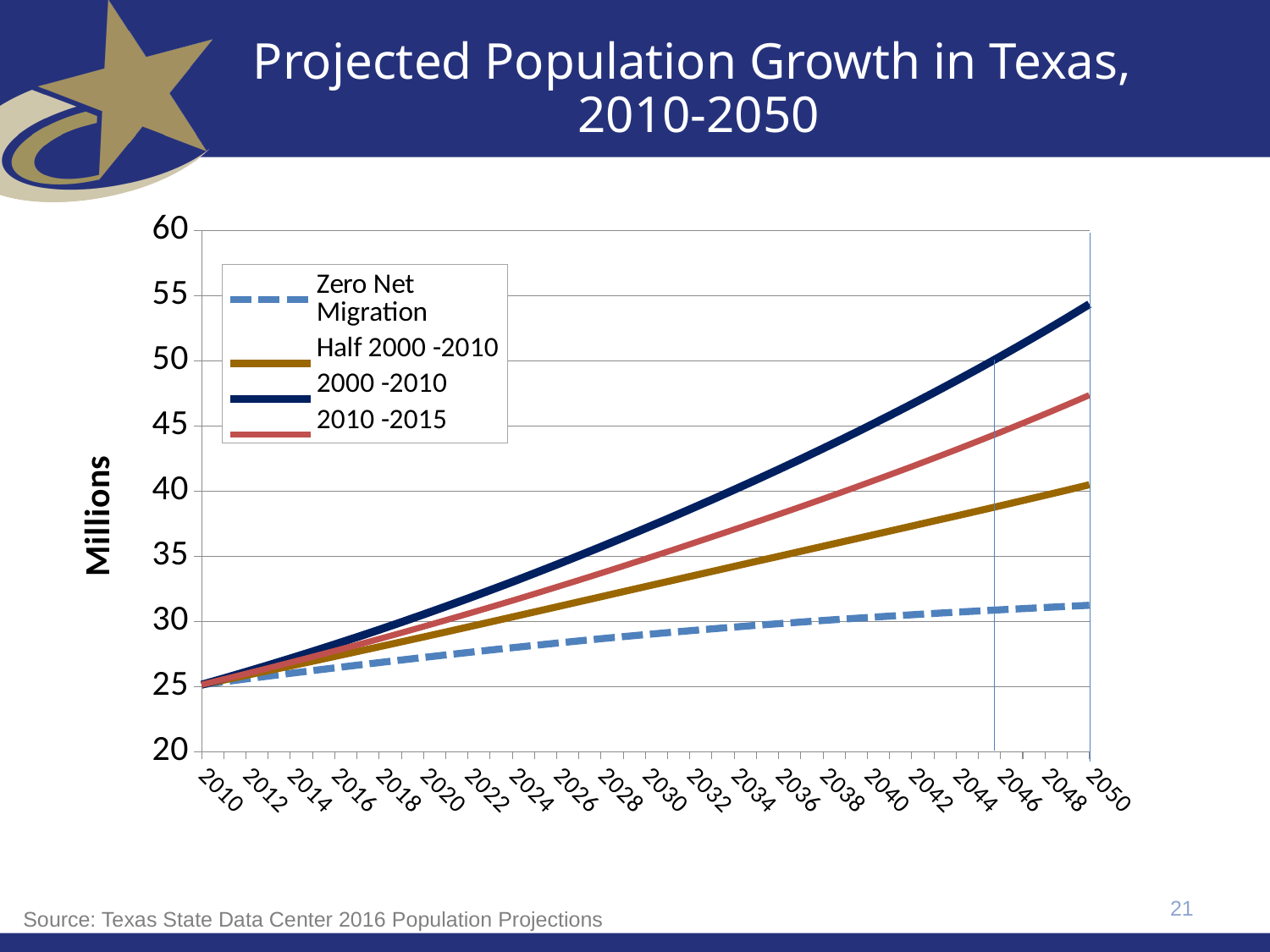
Is the value for the Half 2000 -2010 series in 2050 greater or less than 35? greater Is the value for the 2000 -2010 series in 2050 greater or less than 50? greater In 2050, which is larger: the 2010 -2015 series or the Half 2000 -2010 series? 2010 -2015 What is the label on the vertical axis of the chart? Millions Is the value for the 2010 -2015 series in 2050 greater or less than 45? greater Which series has the highest projected population in 2050? 2000 -2010 How many series does the legend list? 4 Do the values of the 2000 -2010 series rise or fall from 2010 to 2050? rise What kind of chart is shown on the slide? line chart Which series has the lowest projected population in 2050? Zero Net Migration